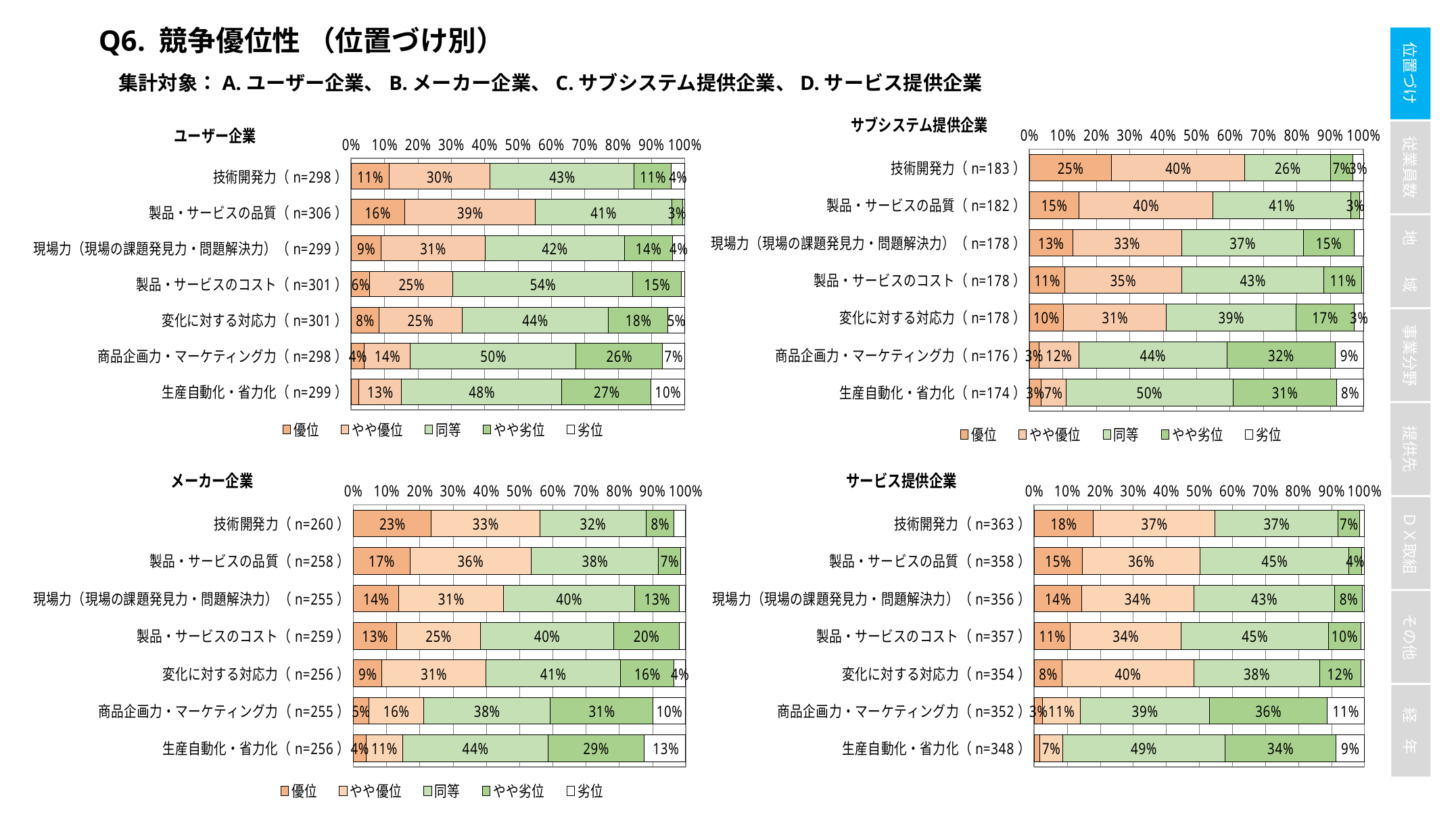
In the ユーザー企業 chart, which category has the highest 同等 value? 製品・サービスのコスト How many categories are plotted in the メーカー企業 chart? 7 In the サービス提供企業 chart, what is the 劣位 value for 生産自動化・省力化 (n=348)? 9% In the サブシステム提供企業 chart, what is the やや劣位 value for 商品企画力・マーケティング力 (n=176)? 32% In the サブシステム提供企業 chart, which category has the highest 優位 value? 技術開発力 What kind of chart is the サブシステム提供企業 chart? Stacked bar chart How many series does the legend of the ユーザー企業 chart list? 5 In the サービス提供企業 chart, which is larger: the 同等 value for 製品・サービスの品質 or the 同等 value for 変化に対する対応力? 製品・サービスの品質 What is the title of the chart in the top-left of the slide? ユーザー企業 In the メーカー企業 chart, what is the 優位 value for 技術開発力 (n=260)? 23% In the ユーザー企業 chart, what is the 同等 value for 製品・サービスのコスト (n=301)? 54% In the メーカー企業 chart, what is the difference between the やや優位 values for 製品・サービスの品質 (36%) and 製品・サービスのコスト (25%)? 11%